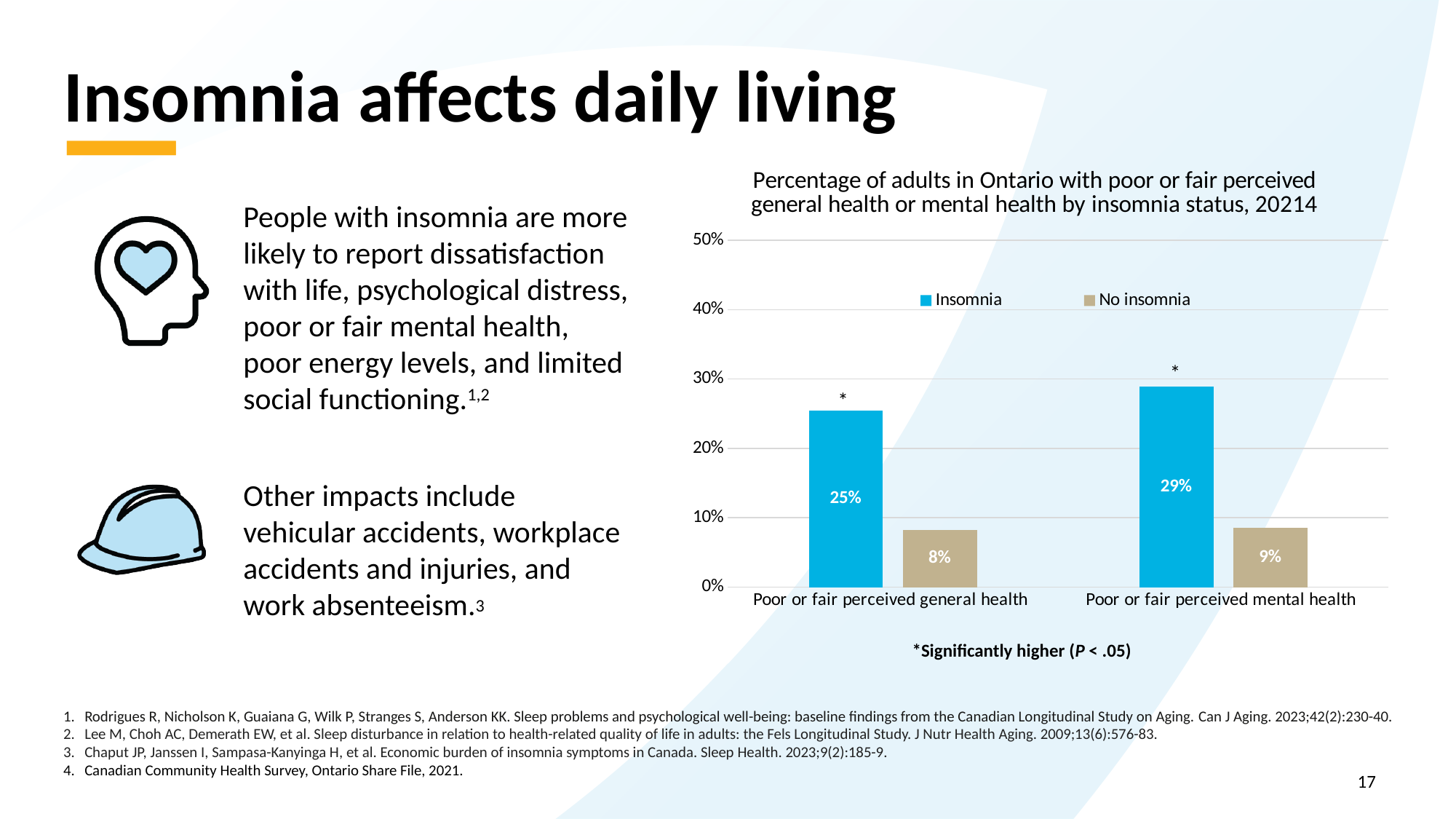
For poor or fair perceived general health, which group has the larger value: Insomnia or No insomnia? Insomnia What percentage of adults with insomnia report poor or fair perceived general health? 25% What is the difference between the Insomnia and No insomnia values for poor or fair perceived general health? 17 percentage points What is the value for the No insomnia series in the poor or fair perceived general health category? 8% What percentage of adults with no insomnia report poor or fair perceived mental health? 9% Which bar in the chart has the lowest value? No insomnia, poor or fair perceived general health What kind of chart is shown on the slide? Bar chart Which bar in the chart has the highest value? Insomnia, poor or fair perceived mental health What is the difference between the Insomnia and No insomnia values for poor or fair perceived mental health? 20 percentage points How many series does the chart legend list? 2 What is the value for the Insomnia series in the poor or fair perceived mental health category? 29% What does the asterisk above the Insomnia bars indicate? Significantly higher (P < .05)